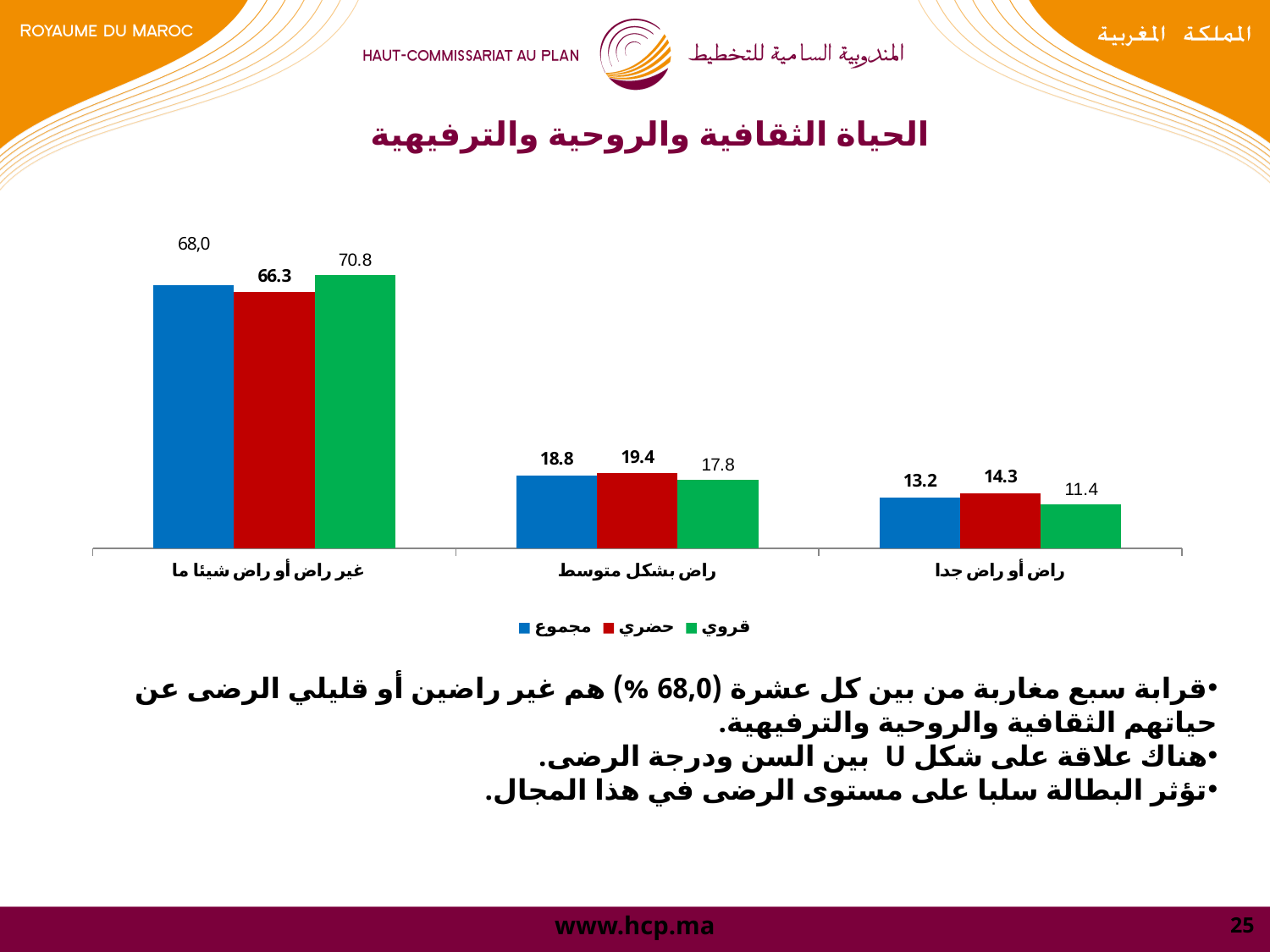
What is the difference between the حضري and قروي values in the category راض بشكل متوسط? 1.6 What is the value for مجموع in the category راض أو راض جدا? 13.2 Which is larger in the category راض أو راض جدا: the value for حضري or the value for مجموع? حضري Which colour represents the series حضري in the chart? red Which series has the lowest value in the category راض أو راض جدا? قروي What kind of chart is shown on the slide? bar chart How many categories are shown on the x axis of the chart? 3 What is the value for قروي in the category راض أو راض جدا? 11.4 How many series does the legend list? 3 Which series has the highest value in the category غير راض أو راض شيئا ما? قروي What is the value for مجموع in the category غير راض أو راض شيئا ما? 68,0 What is the value for حضري in the category راض بشكل متوسط? 19.4